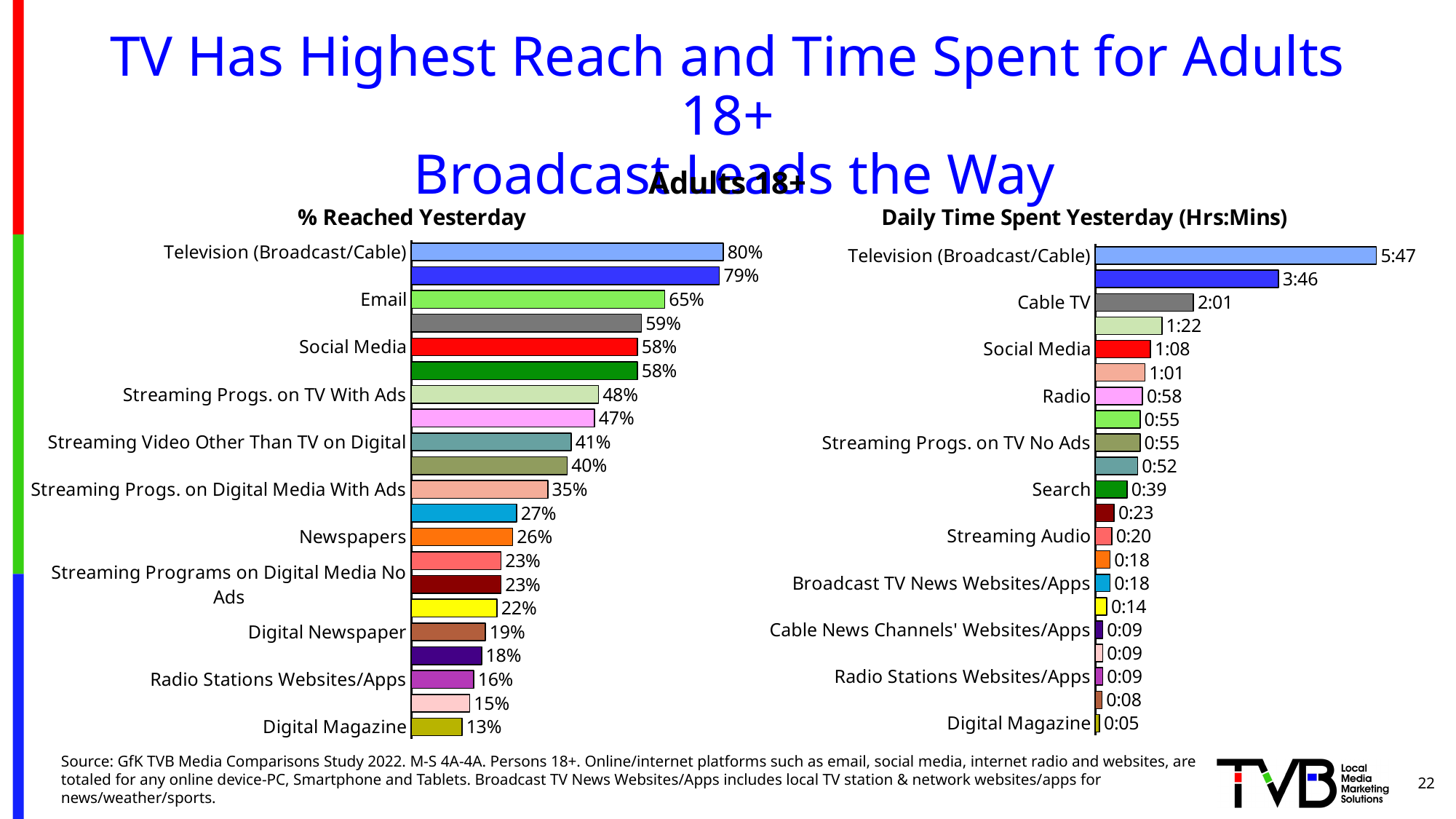
In the "% Reached Yesterday" chart, what is the value for Email? 65% How many bars are plotted in the "% Reached Yesterday" chart? 21 In the "Daily Time Spent Yesterday (Hrs:Mins)" chart, what is the value for Television (Broadcast/Cable)? 5:47 In the "Daily Time Spent Yesterday (Hrs:Mins)" chart, which labeled category has the highest value? Television (Broadcast/Cable) In the "% Reached Yesterday" chart, which is larger, Streaming Progs. on TV With Ads or Digital Newspaper? Streaming Progs. on TV With Ads What kind of chart is the "Daily Time Spent Yesterday (Hrs:Mins)" chart? Bar chart In the "% Reached Yesterday" chart, what is the difference between Social Media and Newspapers? 32% In the "% Reached Yesterday" chart, what is the value for Digital Magazine? 13% In the "% Reached Yesterday" chart, what is the value for Television (Broadcast/Cable)? 80% In the "Daily Time Spent Yesterday (Hrs:Mins)" chart, what is the value for Cable TV? 2:01 In the "Daily Time Spent Yesterday (Hrs:Mins)" chart, what is the value for Search? 0:39 In the "% Reached Yesterday" chart, which labeled category has the lowest value? Digital Magazine